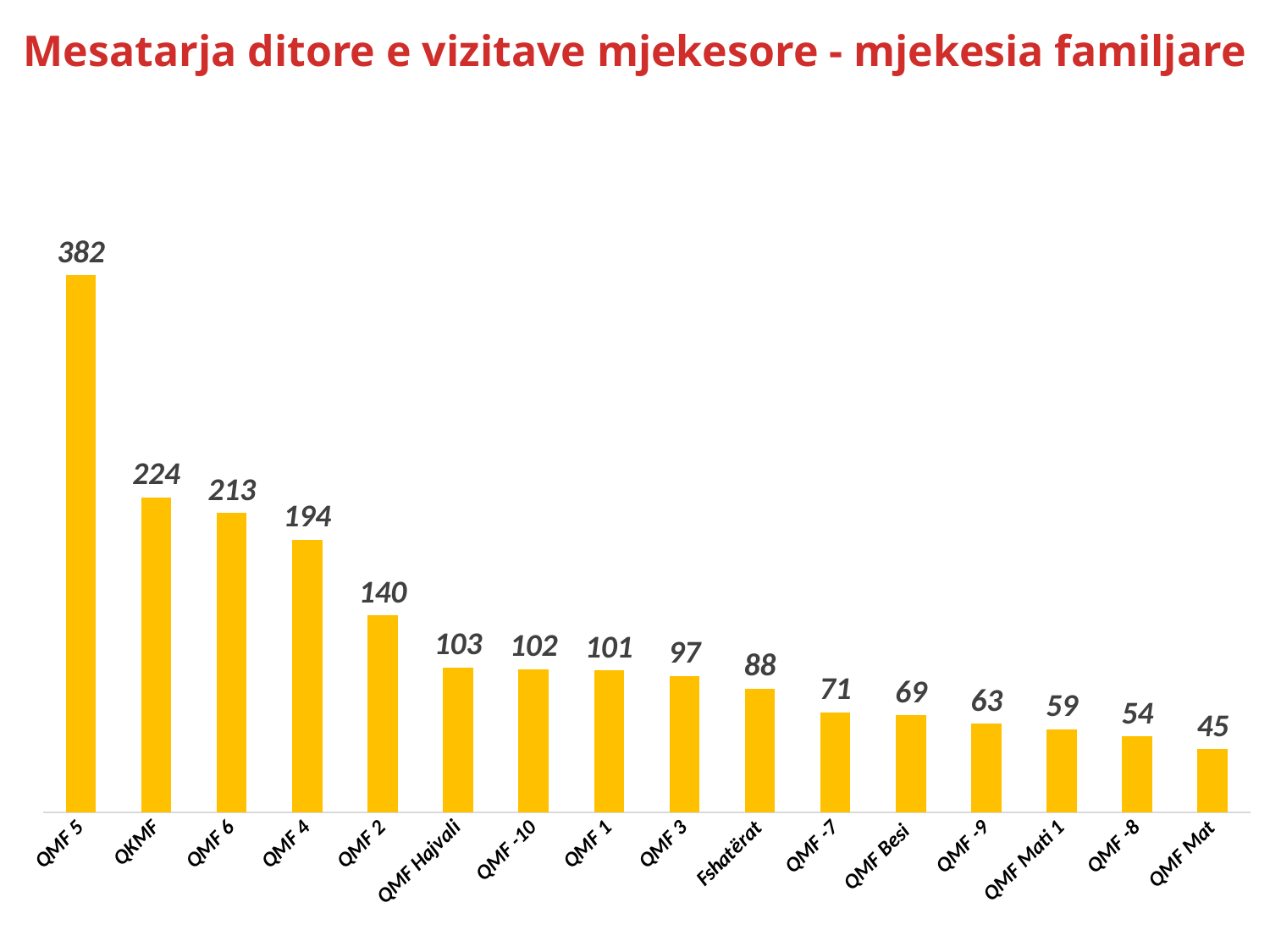
What kind of chart is shown on the slide? Bar chart What is the difference between the values for QMF 2 and QMF 3? 43 Which category has the lowest value? QMF Mat What is the title of the chart? Mesatarja ditore e vizitave mjekesore - mjekesia familjare Which is larger, the value for QMF 6 or the value for QMF 4? QMF 6 What is the value for QMF Besi? 69 What is the value for Fshatërat? 88 What is the value for QMF Hajvali? 103 Which category has the highest value? QMF 5 How many categories are shown in the chart? 16 What is the value for QMF 5? 382 What is the difference between the values for QMF 5 and QKMF? 158